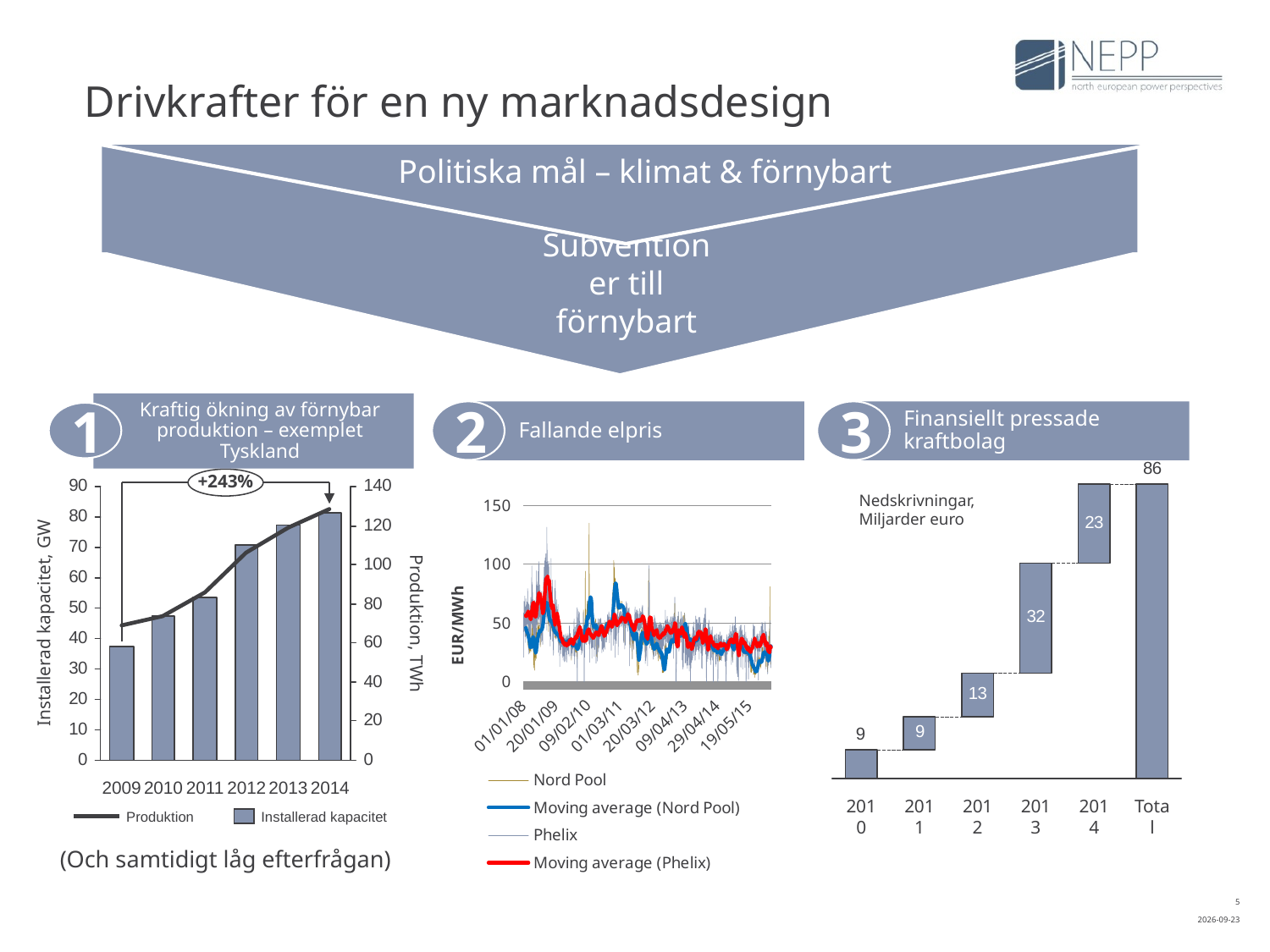
In the chart 'Kraftig ökning av förnybar produktion – exemplet Tyskland', what percentage increase is annotated above the bars? +243% In the chart 'Kraftig ökning av förnybar produktion – exemplet Tyskland', is the installed capacity for 2012 greater or less than 60? greater How many series does the legend of the chart 'Fallande elpris' list? 4 How many bars are shown in the chart 'Finansiellt pressade kraftbolag'? 6 In the chart 'Kraftig ökning av förnybar produktion – exemplet Tyskland', do the installed capacity bars rise or fall from 2009 to 2014? rise In the chart 'Fallande elpris', what unit is shown on the y axis? EUR/MWh In the chart 'Finansiellt pressade kraftbolag', which is larger, the value for 2012 or the value for 2014? 2014 In the chart 'Finansiellt pressade kraftbolag', what is the value for 2013? 32 In the chart 'Finansiellt pressade kraftbolag', what is the difference between the values for 2013 and 2014? 9 In the chart 'Finansiellt pressade kraftbolag', what is the value of the Total bar? 86 In the chart 'Finansiellt pressade kraftbolag', which year has the highest value? 2013 In the chart 'Kraftig ökning av förnybar produktion – exemplet Tyskland', is the installed capacity for 2009 greater or less than 40? less